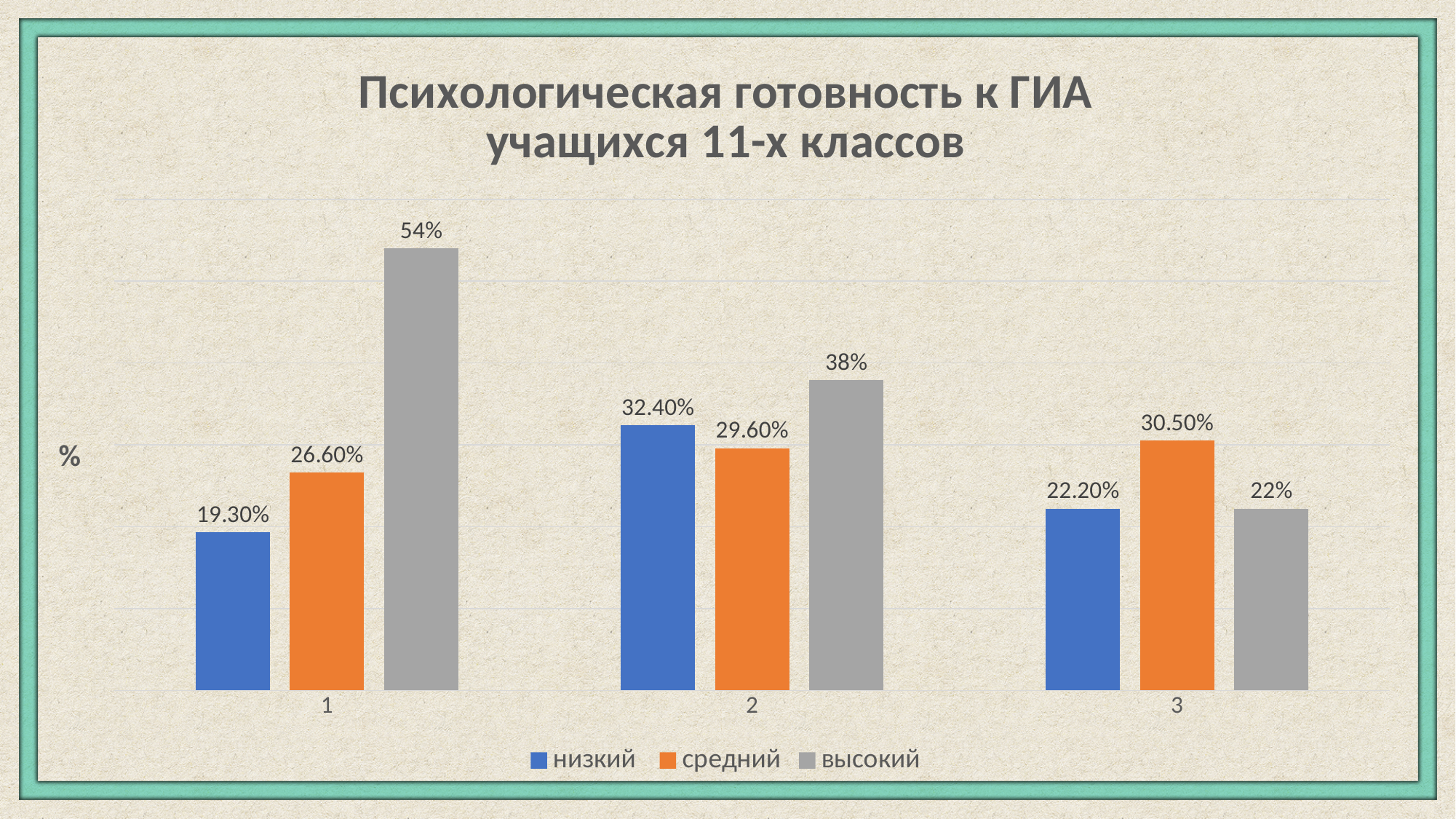
Which category has the lowest value for the 'низкий' series? 1 What is the value of the 'высокий' series for category 1? 54% Which is larger for category 3: the 'низкий' value or the 'средний' value? средний What is the value of the 'средний' series for category 3? 30.50% Which category has the highest value for the 'высокий' series? 1 What is the value of the 'низкий' series for category 2? 32.40% How many categories are shown on the x axis? 3 How many series does the legend list? 3 What kind of chart is shown on the slide? bar chart What is the title of the chart? Психологическая готовность к ГИА учащихся 11-х классов What is the value of the 'низкий' series for category 1? 19.30% What is the difference between the 'высокий' values for category 1 and category 2? 16%